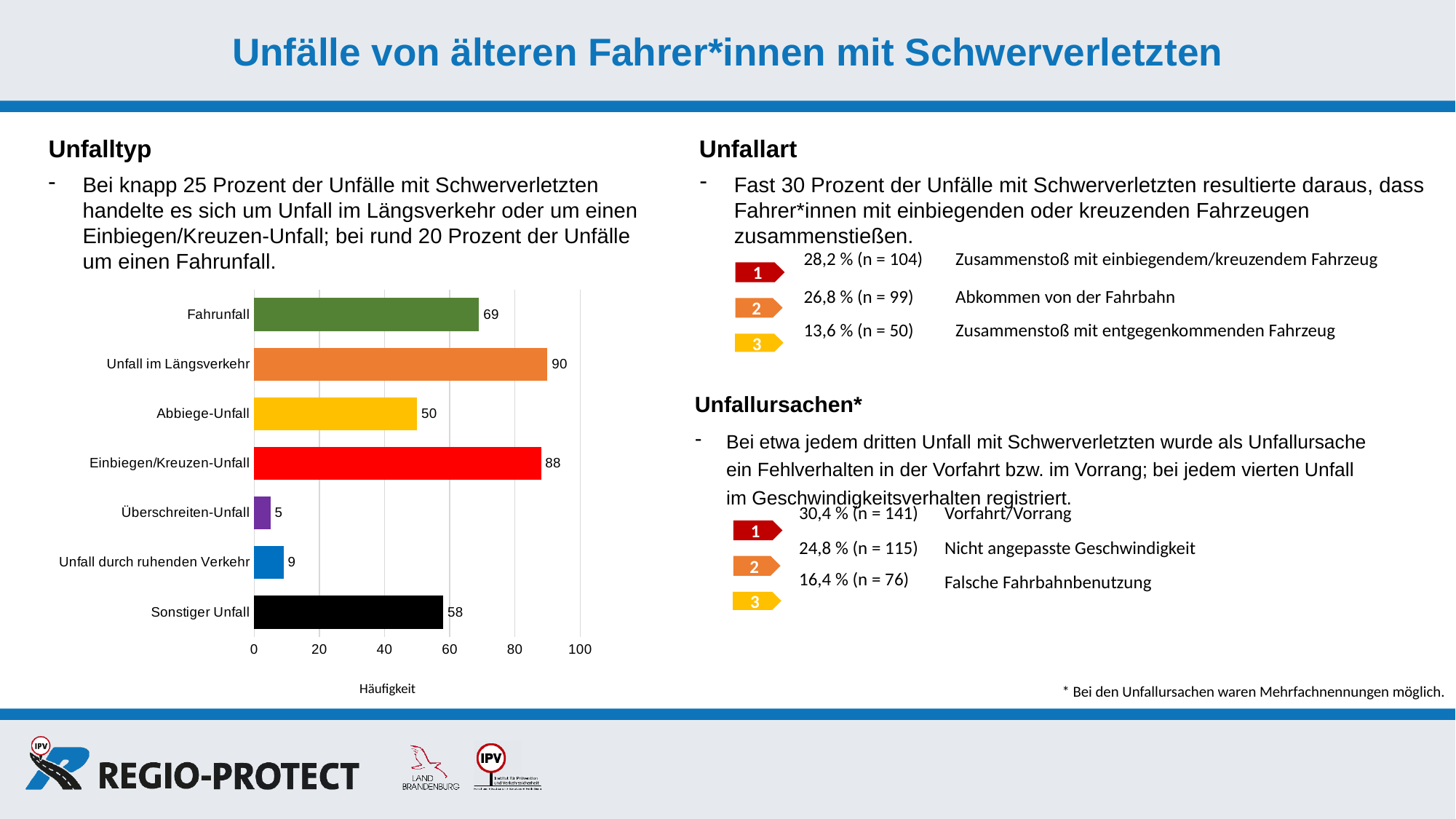
What is the difference between the values for Unfall im Längsverkehr and Einbiegen/Kreuzen-Unfall? 2 Which category has the highest value in the bar chart? Unfall im Längsverkehr How many categories are shown in the bar chart? 7 What is the value for Fahrunfall in the bar chart? 69 What is the value for Abbiege-Unfall in the bar chart? 50 What kind of chart is shown on the slide? bar chart Is the value for Einbiegen/Kreuzen-Unfall greater or less than 80? greater What is the label of the horizontal axis of the bar chart? Häufigkeit Which is larger in the bar chart: Fahrunfall or Sonstiger Unfall? Fahrunfall What is the value for Unfall im Längsverkehr in the bar chart? 90 What is the value for Sonstiger Unfall in the bar chart? 58 Which category has the lowest value in the bar chart? Überschreiten-Unfall